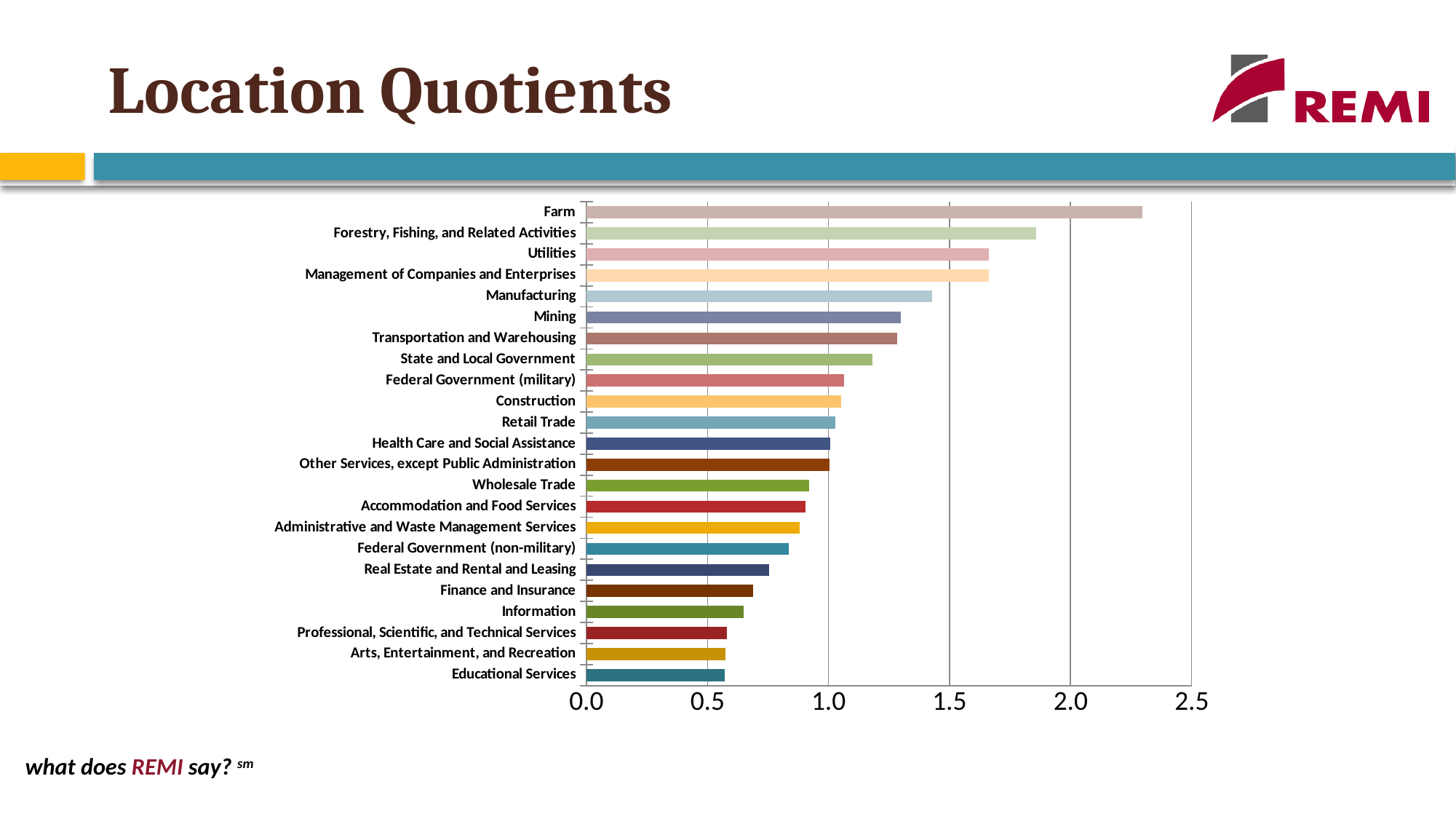
How many categories are plotted in the chart? 23 Is the value for Educational Services greater or less than 0.5? greater Is the value for Forestry, Fishing, and Related Activities greater or less than 1.5? greater Is the value for Farm greater or less than 2.0? greater Which category has the highest location quotient? Farm What kind of chart is shown on the slide? bar chart Which has a larger value, Farm or Manufacturing? Farm Which has a larger value, Wholesale Trade or Mining? Mining What is the title of the slide containing the chart? Location Quotients